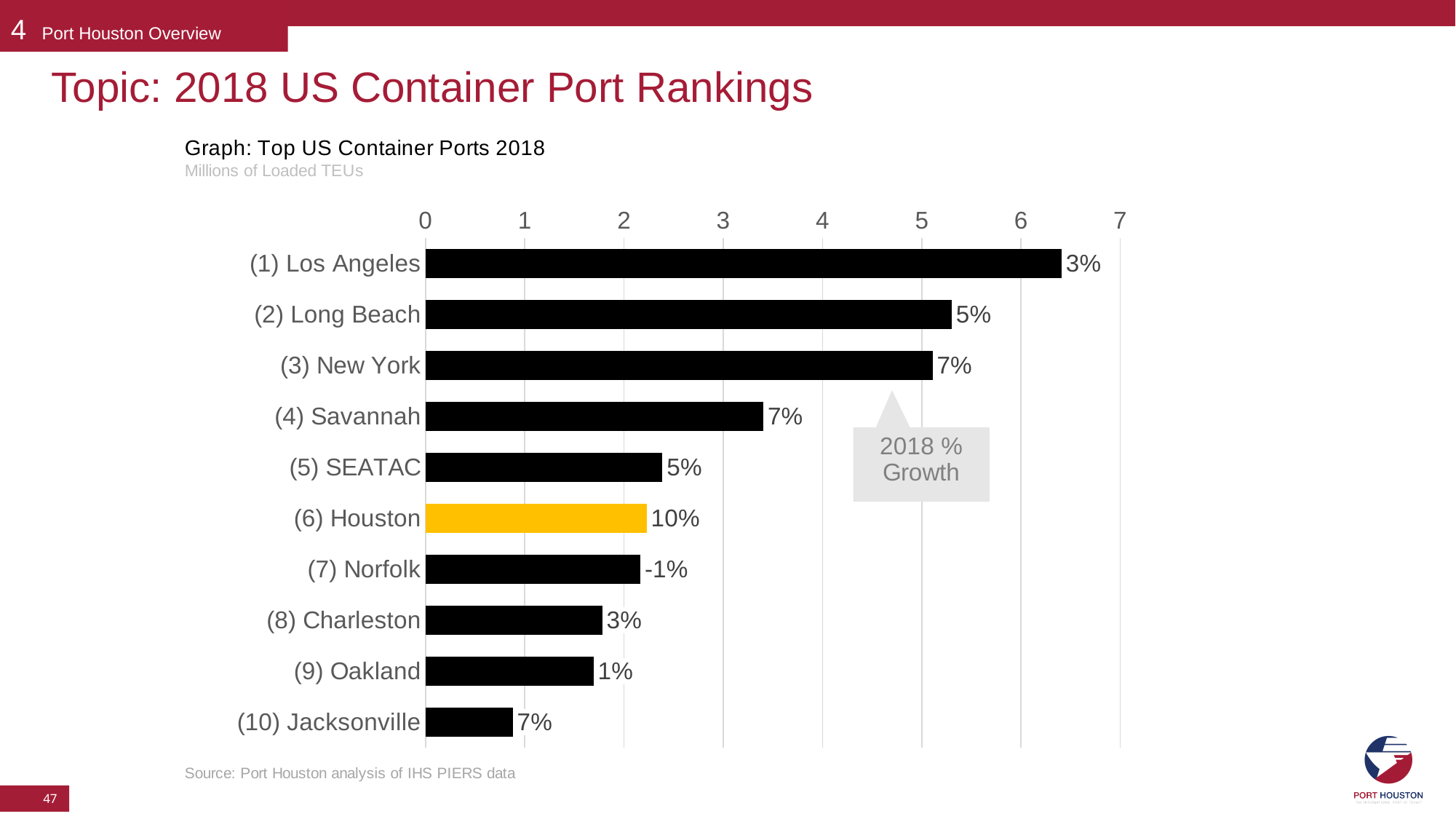
Is the value for Jacksonville greater or less than 1 million loaded TEUs? less Which port has the shortest bar (lowest loaded TEUs) in the chart? (10) Jacksonville What 2018 % growth is labelled for Los Angeles? 3% What 2018 % growth is labelled for Norfolk? -1% What 2018 % growth is labelled for Houston? 10% What kind of chart is shown on the slide? bar chart Is the value for Los Angeles greater or less than 6 million loaded TEUs? greater How many ports are shown in the chart? 10 What is the difference in percentage points between Houston's 2018 % growth and Norfolk's 2018 % growth? 11 percentage points Which port has the longest bar (highest loaded TEUs) in the chart? (1) Los Angeles Which bar is highlighted in a different colour (yellow) from the others? (6) Houston Which port has the highest 2018 % growth label? (6) Houston